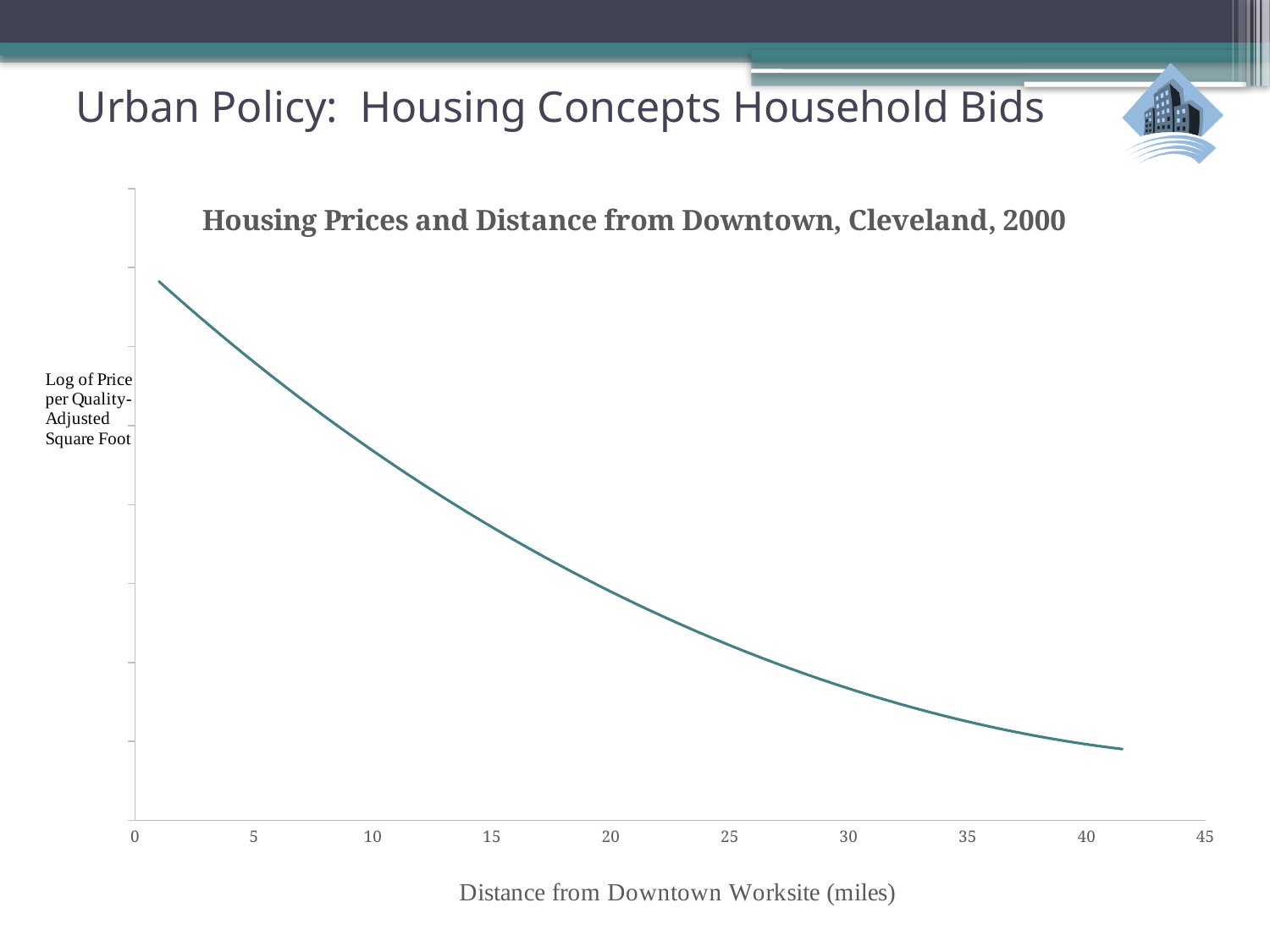
What is the interval between consecutive tick labels on the x axis? 5 What kind of chart is shown on the slide? Line chart Which is larger, the value at 10 miles or the value at 30 miles from downtown? 10 miles What is the label on the x axis of the chart? Distance from Downtown Worksite (miles) What is the largest value shown on the x axis of the chart? 45 What is the title of the chart? Housing Prices and Distance from Downtown, Cleveland, 2000 As distance from the downtown worksite increases along the x axis, does the log of price per quality-adjusted square foot rise or fall? Fall Which is larger, the value at 5 miles or the value at 40 miles from downtown? 5 miles